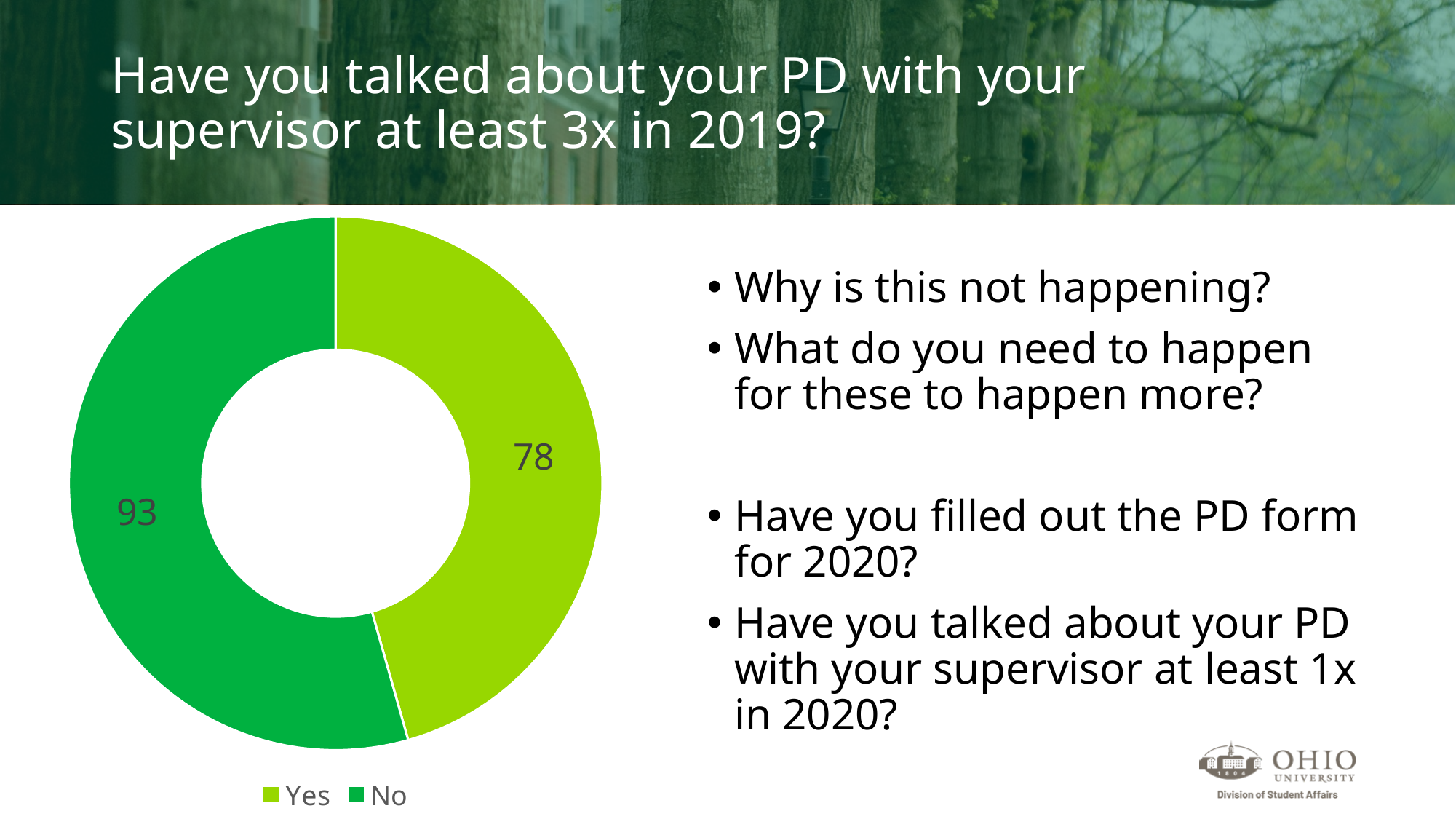
Is the value for No greater or less than 80? greater How many respondents answered No? 93 What is the difference between the No count and the Yes count? 15 Which response has the smaller count? Yes What is the total number of responses shown in the chart? 171 How many respondents answered Yes? 78 What kind of chart is shown on the slide? doughnut chart How many categories does the chart show? 2 What are the two legend entries of the chart? Yes and No Which response has the larger count, Yes or No? No Which colour represents the No category in the chart? dark green Is the value for Yes larger or smaller than the value for No? smaller